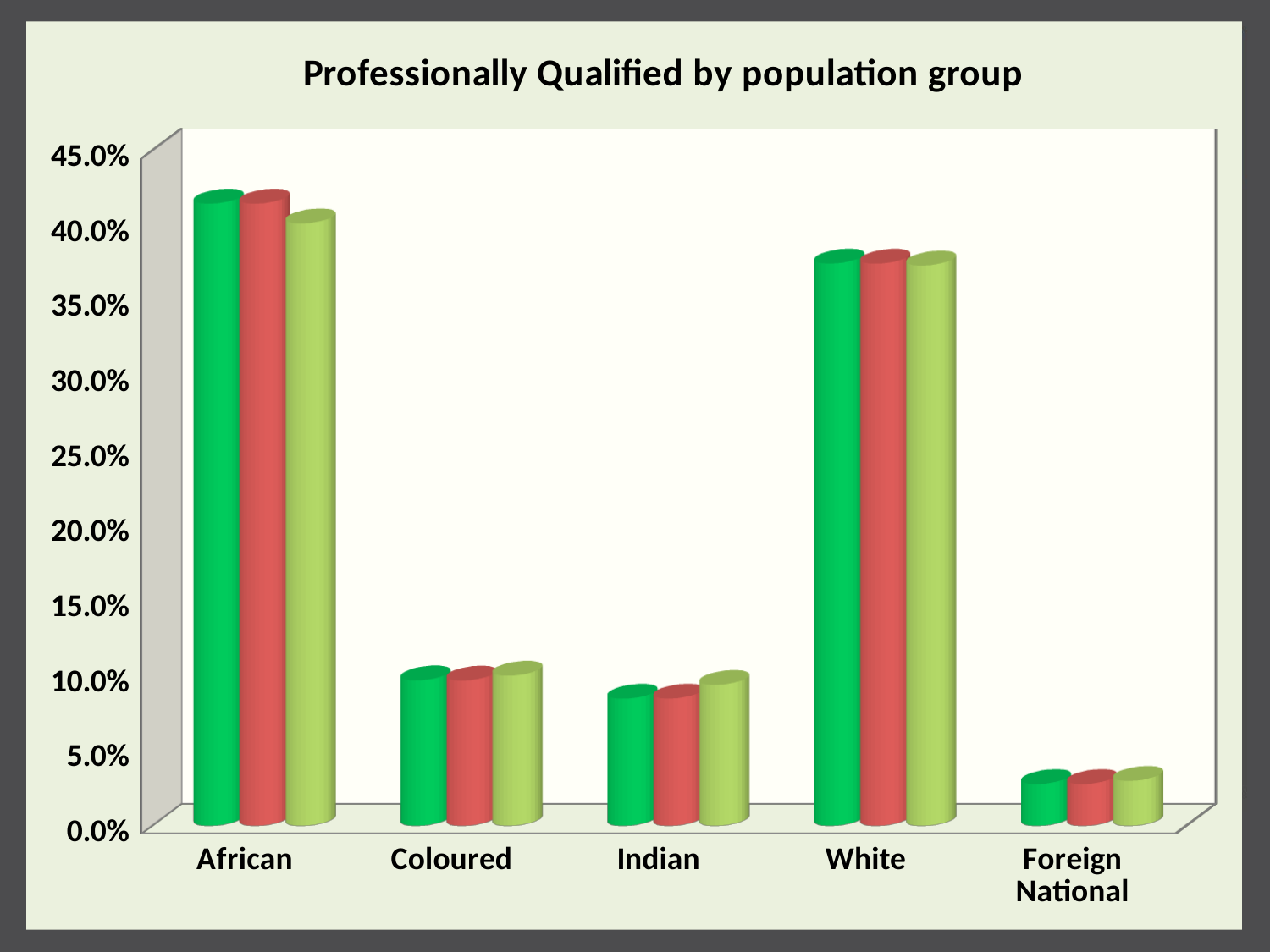
Are the values for White greater or less than 35.0%? greater Which has higher values, White or Coloured? White Which population group has the lowest values? Foreign National What type of chart is shown on the slide? bar chart How many population groups are shown on the x axis? 5 Are the values for Foreign National greater or less than 5.0%? less Which population group has the highest values? African What is the title of the chart? Professionally Qualified by population group Are the values for Indian greater or less than 10.0%? less Which has higher values, African or White? African